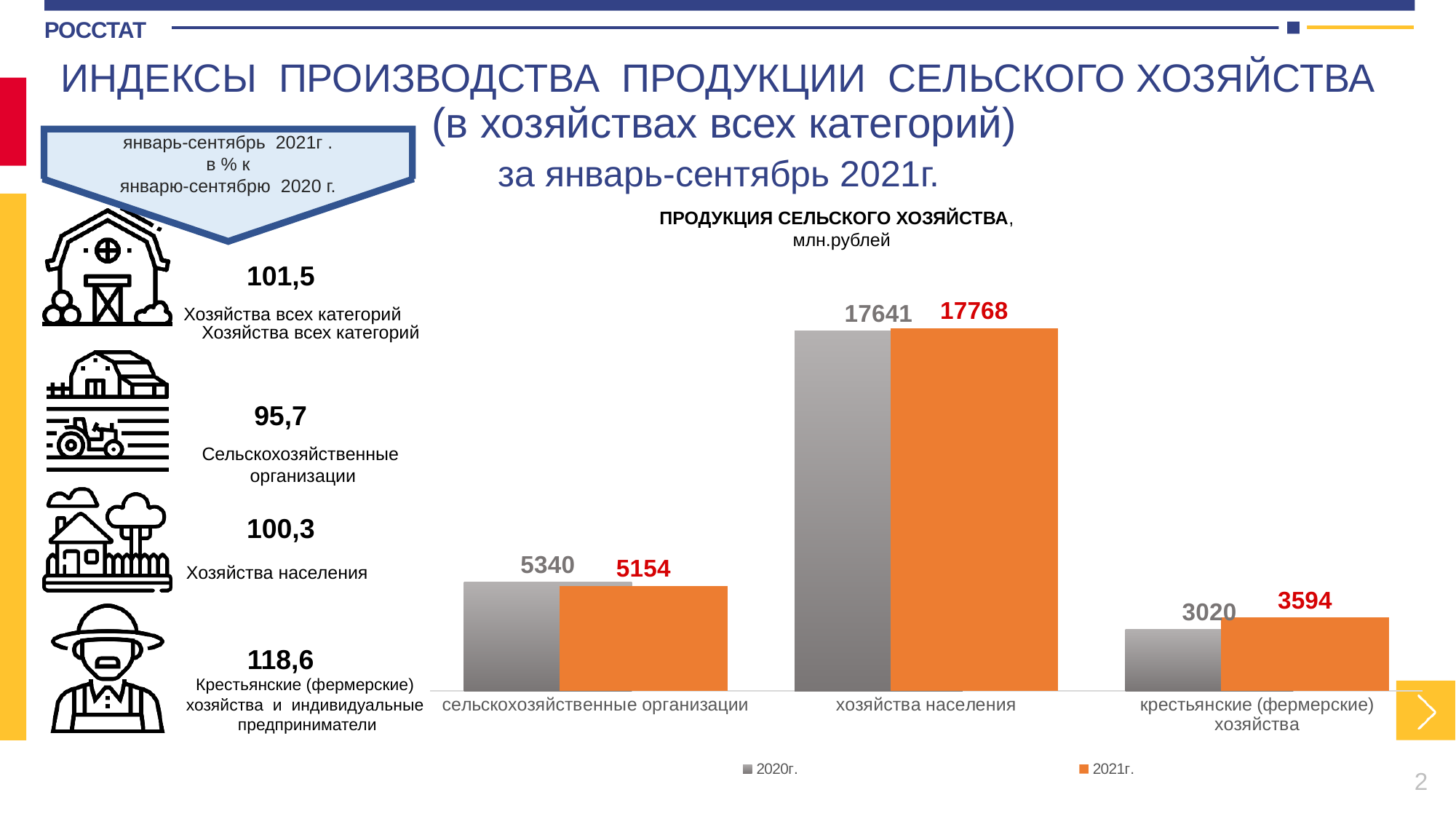
What is the difference between the 2020г. and 2021г. values for сельскохозяйственные организации? 186 How many series does the chart legend list? 2 What is the value for сельскохозяйственные организации in the 2020г. series? 5340 How many categories are shown on the x axis of the chart? 3 For сельскохозяйственные организации, which series has the larger value, 2020г. or 2021г.? 2020г. What kind of chart is shown on the slide? bar chart Which category has the lowest value in the 2020г. series? крестьянские (фермерские) хозяйства What is the difference between the 2021г. and 2020г. values for крестьянские (фермерские) хозяйства? 574 What is the value for крестьянские (фермерские) хозяйства in the 2021г. series? 3594 What is the value for хозяйства населения in the 2021г. series? 17768 Which category has the highest value in the 2021г. series? хозяйства населения For хозяйства населения, which series has the larger value, 2020г. or 2021г.? 2021г.